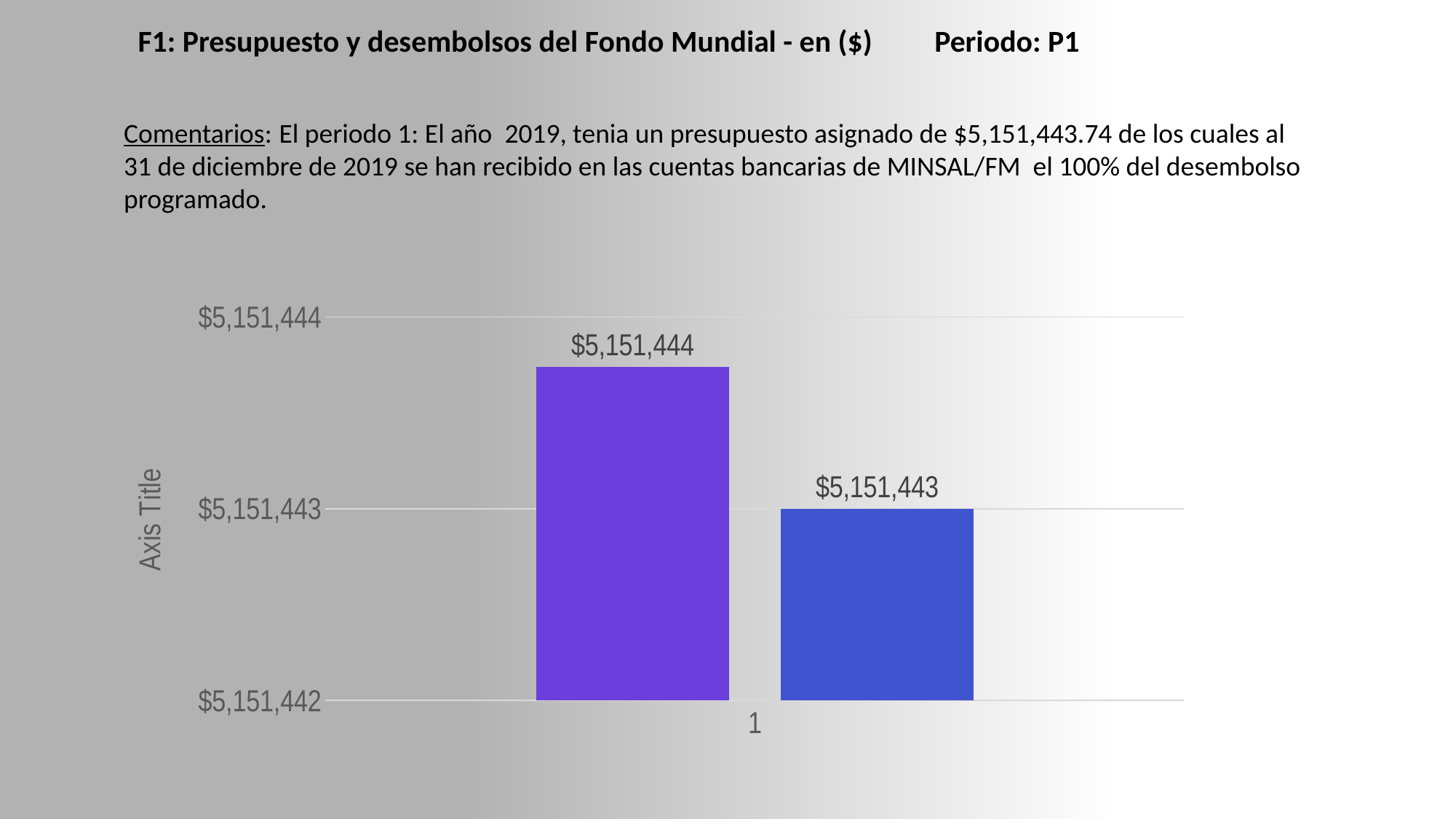
What is the value shown on the data label of the right (blue) bar? $5,151,443 Which bar is taller, the left purple bar or the right blue bar? the left purple bar What is the value shown on the data label of the left (purple) bar? $5,151,444 Which bar has the lowest value? the right blue bar What is the title of the vertical axis? Axis Title Is the value of the left (purple) bar greater or less than $5,151,443? greater Is the value of the right (blue) bar greater or less than $5,151,444? less How many bars are plotted in the chart? 2 How many categories are shown on the x axis? 1 What is the label of the category on the x axis? 1 What is the difference between the left bar's value and the right bar's value? $1 What kind of chart is shown on the slide? bar chart